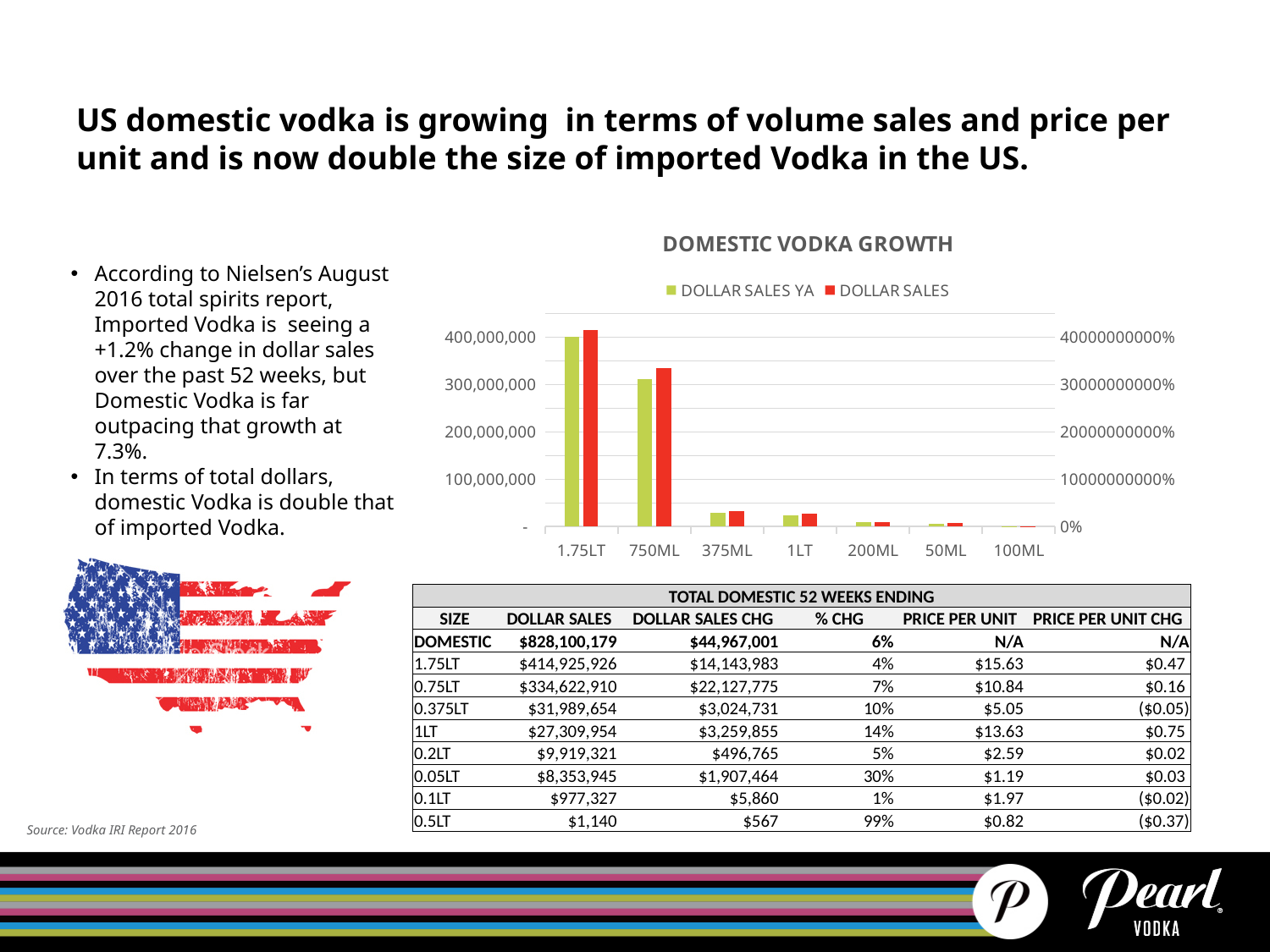
In the DOMESTIC VODKA GROWTH chart, is the DOLLAR SALES value for 750ML greater or less than 300,000,000? greater What type of chart is shown under the title DOMESTIC VODKA GROWTH? bar chart Which size category has the highest DOLLAR SALES in the DOMESTIC VODKA GROWTH chart? 1.75LT In the DOMESTIC VODKA GROWTH chart, which has higher DOLLAR SALES, 750ML or 375ML? 750ML In the DOMESTIC VODKA GROWTH chart, is the DOLLAR SALES value for 375ML greater or less than 100,000,000? less How many size categories are shown on the x axis of the DOMESTIC VODKA GROWTH chart? 7 Do the DOLLAR SALES values in the DOMESTIC VODKA GROWTH chart rise or fall moving from left to right along the x axis? fall How many series does the legend of the DOMESTIC VODKA GROWTH chart list? 2 In the DOMESTIC VODKA GROWTH chart, is the DOLLAR SALES YA value for 1LT greater or less than 100,000,000? less Which colour represents the DOLLAR SALES series in the DOMESTIC VODKA GROWTH chart? red Which size category has the lowest DOLLAR SALES in the DOMESTIC VODKA GROWTH chart? 100ML